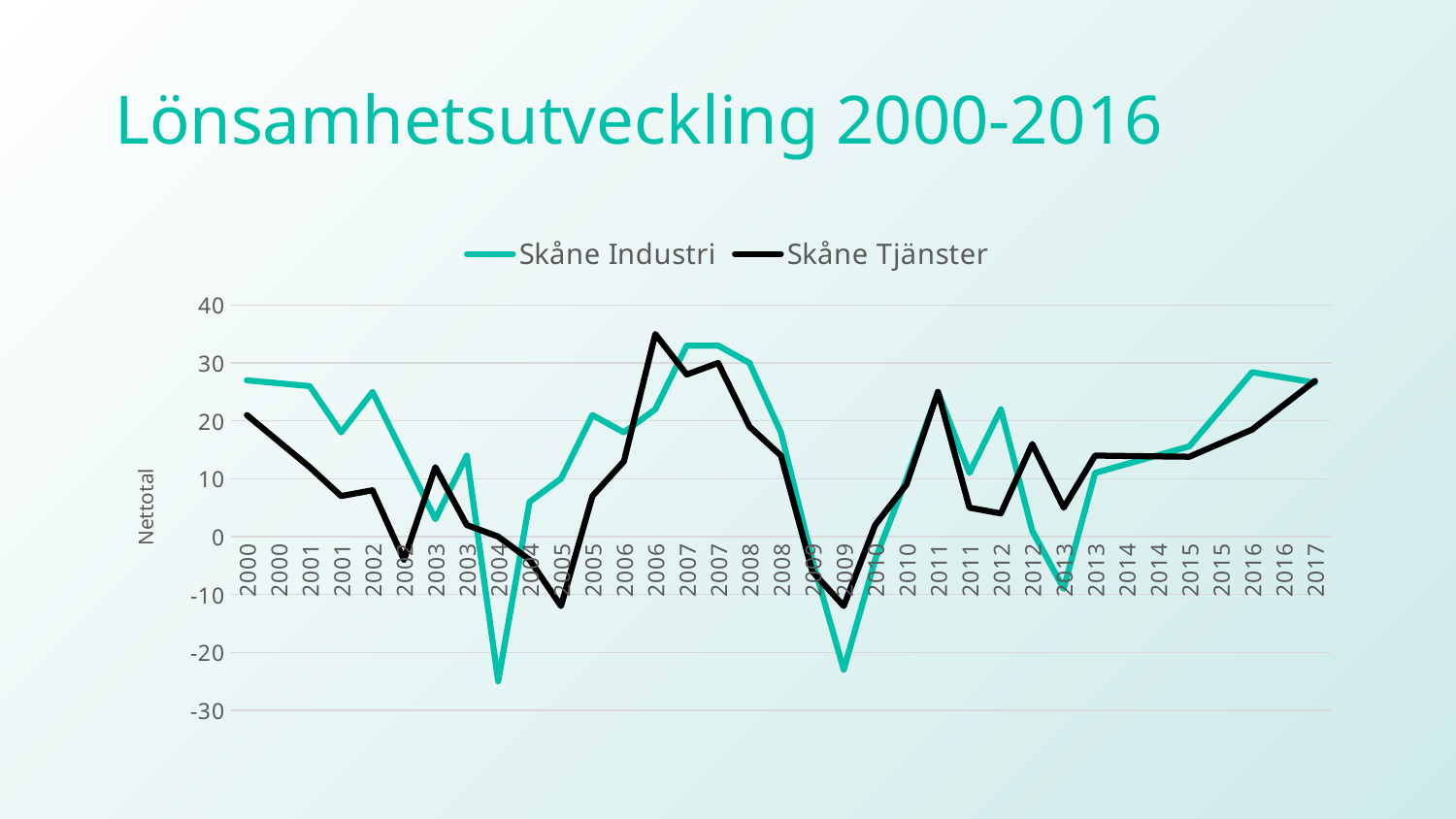
Is the value for Skåne Industri at the start of 2000 greater or less than 20? greater At the first point of 2000, which series has the higher value, Skåne Industri or Skåne Tjänster? Skåne Industri How many series does the legend list? 2 Is the lowest value of Skåne Industri, reached in 2004, greater or less than -20? less In which year does Skåne Industri reach its lowest value? 2004 Does the Skåne Tjänster line rise or fall between 2013 and 2017? rise What are the two series named in the legend? Skåne Industri and Skåne Tjänster Is the peak value of Skåne Tjänster in 2006 greater or less than 30? greater In which year does Skåne Tjänster reach its highest value? 2006 At the peak in 2006, which series is higher, Skåne Industri or Skåne Tjänster? Skåne Tjänster What kind of chart is shown on the slide? Line chart What is the label on the vertical axis? Nettotal